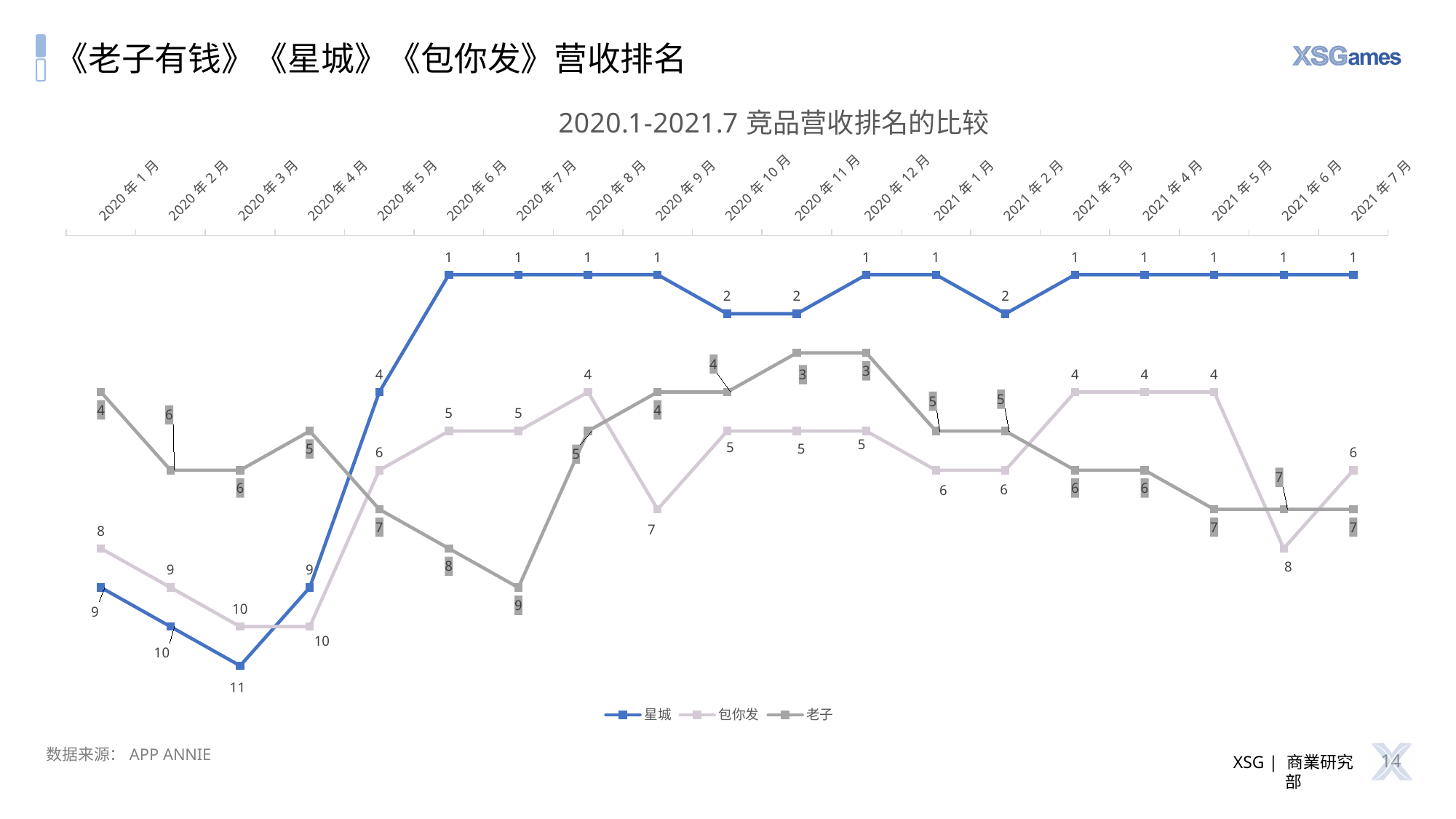
Which series has the larger value in 2020年1月, 星城 or 老子? 星城 What kind of chart is shown on the slide? line chart What is the difference between the 包你发 value and the 老子 value in 2021年6月? 1 What is the value for 包你发 in 2020年8月? 4 What is the title of the chart? 2020.1-2021.7 竞品营收排名的比较 Which month has the largest value for 星城? 2020年3月 What is the value for 星城 in 2020年3月? 11 What is the value for 星城 in 2021年2月? 2 What is the value for 老子 in 2020年7月? 9 How many months are plotted along the x axis? 19 Do the values for 老子 rise or fall from 2020年4月 to 2020年7月? rise How many series does the legend list? 3